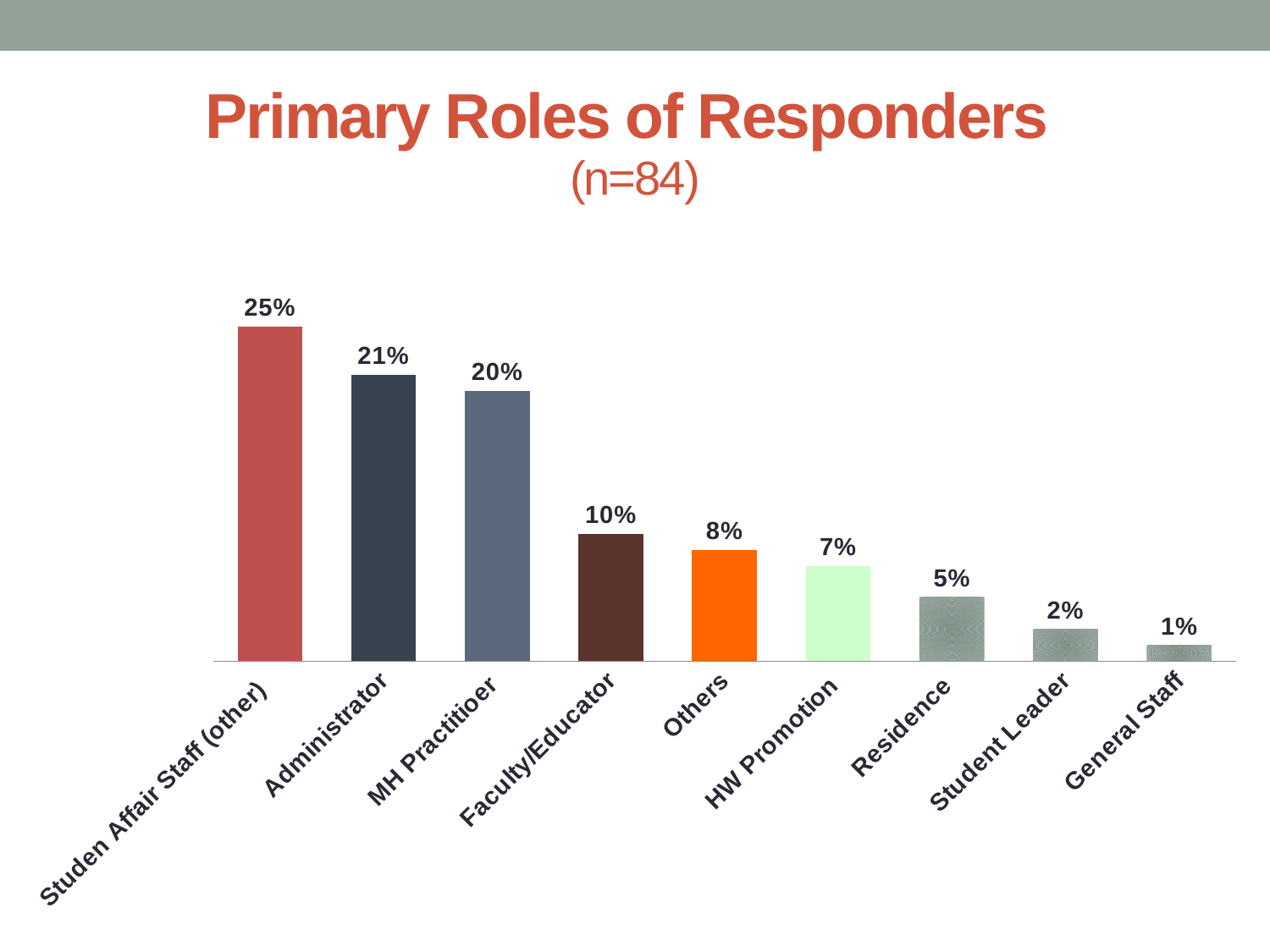
What percentage is shown for HW Promotion? 7% What percentage of responders are Administrators? 21% What is the value shown for Faculty/Educator? 10% Which is larger, the value for Student Leader or the value for Residence? Residence Which is larger, the value for Administrator or the value for MH Practitioer? Administrator What is the difference in percentage points between Studen Affair Staff (other) and MH Practitioer? 5 Which category has the highest percentage of responders? Studen Affair Staff (other) What is the difference in percentage points between Others and Residence? 3 What is the sample size (n) given in the chart title? 84 Which category has the lowest percentage of responders? General Staff How many categories are shown on the chart? 9 What kind of chart is shown on the slide? Bar chart